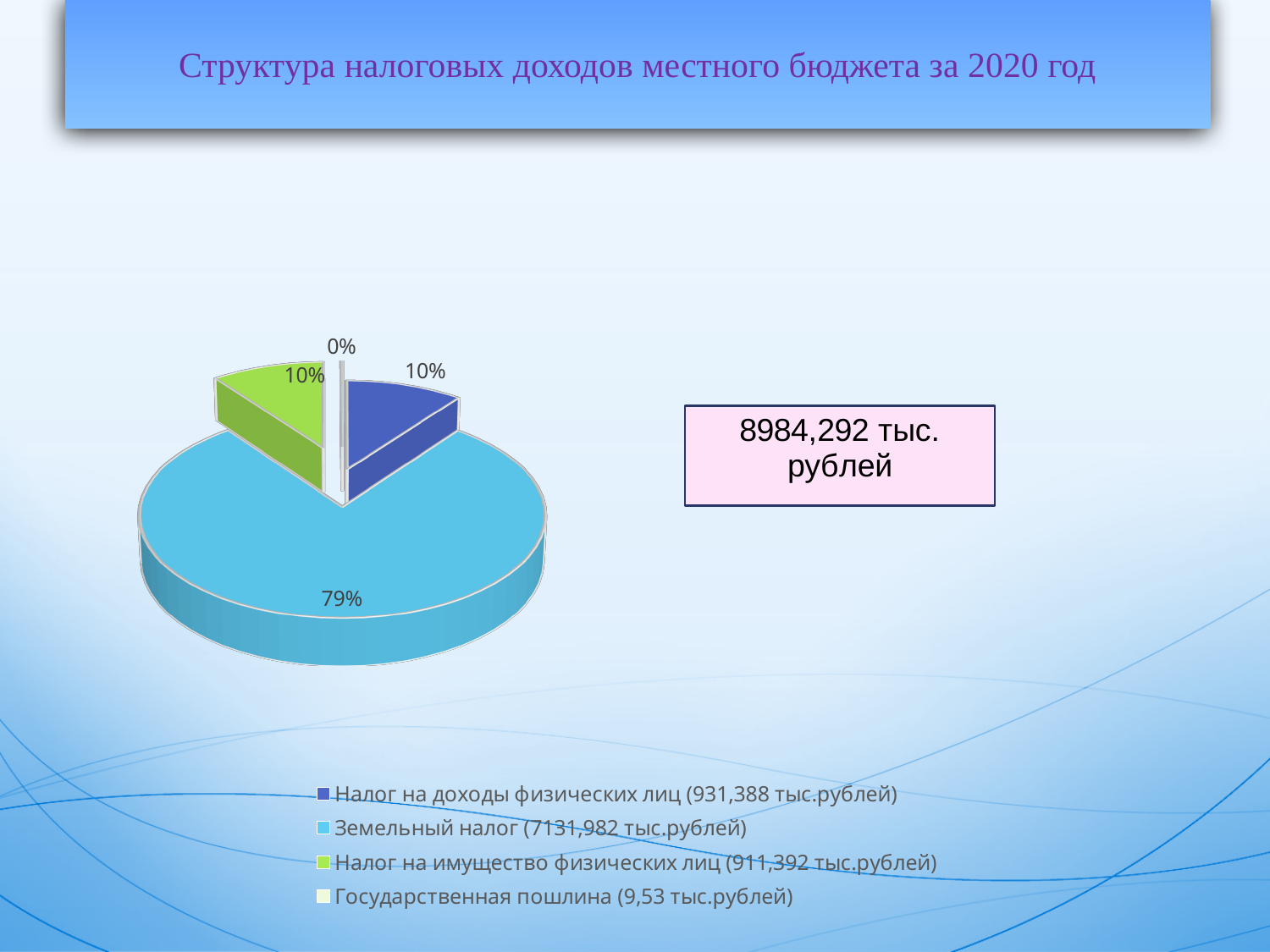
What share of the pie does Налог на доходы физических лиц account for? 10% What is the title of the slide containing the chart? Структура налоговых доходов местного бюджета за 2020 год What is the difference in percentage points between the share of Земельный налог and the share of Налог на имущество физических лиц? 69 Which category has the largest slice of the pie? Земельный налог Which is larger: the share of Земельный налог or the share of Налог на доходы физических лиц? Земельный налог What share of the pie does Земельный налог account for? 79% According to the legend, what amount is given for Земельный налог? 7131,982 тыс.рублей What kind of chart is shown on the slide? Pie chart Which category has the smallest slice of the pie? Государственная пошлина How many slices does the pie chart have? 4 What share of the pie does Государственная пошлина account for? 0% According to the legend, what amount is given for Государственная пошлина? 9,53 тыс.рублей